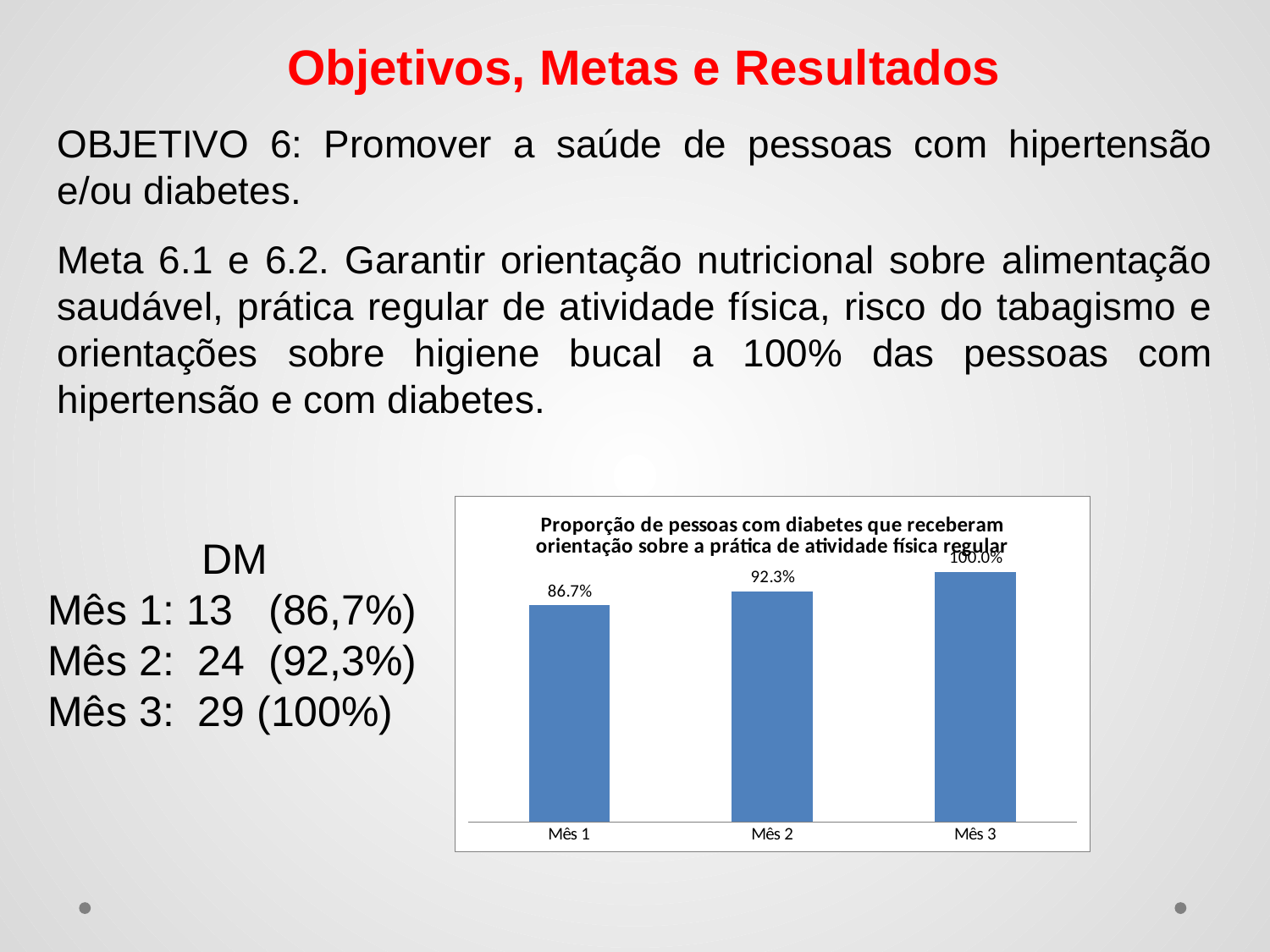
What is the difference between the values for Mês 3 and Mês 1? 13.3% What is the value for Mês 3 in the chart? 100.0% Which is larger, the value for Mês 2 or the value for Mês 1? Mês 2 What is the value for Mês 2 in the chart? 92.3% What is the value for Mês 1 in the chart? 86.7% How many categories are shown on the x axis of the chart? 3 Which month has the lowest value in the chart? Mês 1 What kind of chart is shown on the slide? Bar chart What is the title of the chart? Proporção de pessoas com diabetes que receberam orientação sobre a prática de atividade física regular Which month has the highest value in the chart? Mês 3 Do the values rise or fall from Mês 1 to Mês 3? Rise What is the difference between the values for Mês 2 and Mês 1? 5.6%